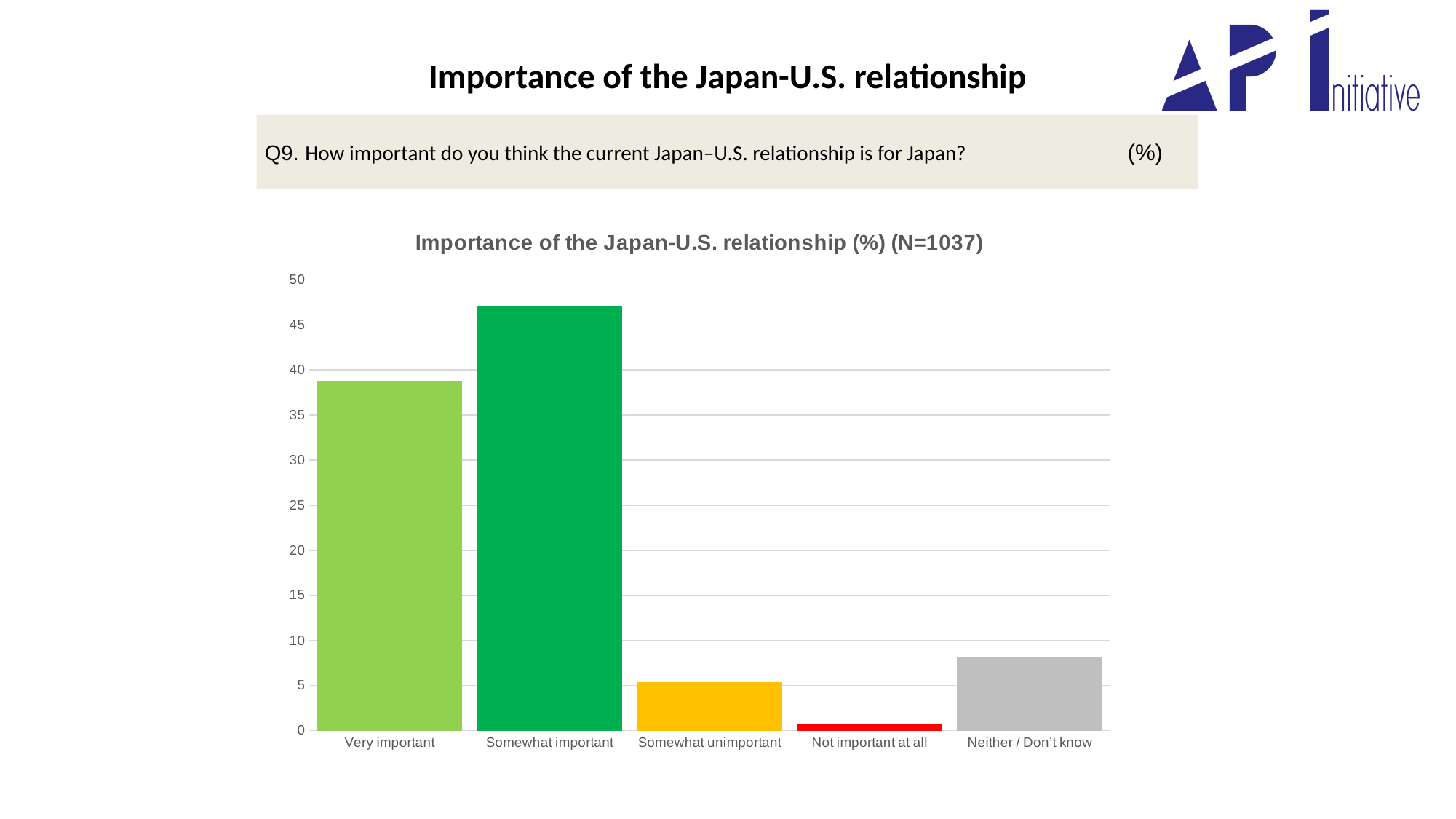
Which is larger, the value for Somewhat unimportant or the value for Neither / Don't know? Neither / Don't know How many categories are shown on the x axis of the chart? 5 Which category has the lowest value in the chart? Not important at all Which category has the highest value in the chart? Somewhat important Is the value for Somewhat unimportant greater or less than 10? less Is the value for Neither / Don't know greater or less than 10? less What colour is the bar for Not important at all? red What kind of chart is shown on the slide? bar chart Is the value for Very important greater or less than 35? greater What is the title of the chart? Importance of the Japan-U.S. relationship (%) (N=1037) Which is larger, the value for Very important or the value for Somewhat important? Somewhat important